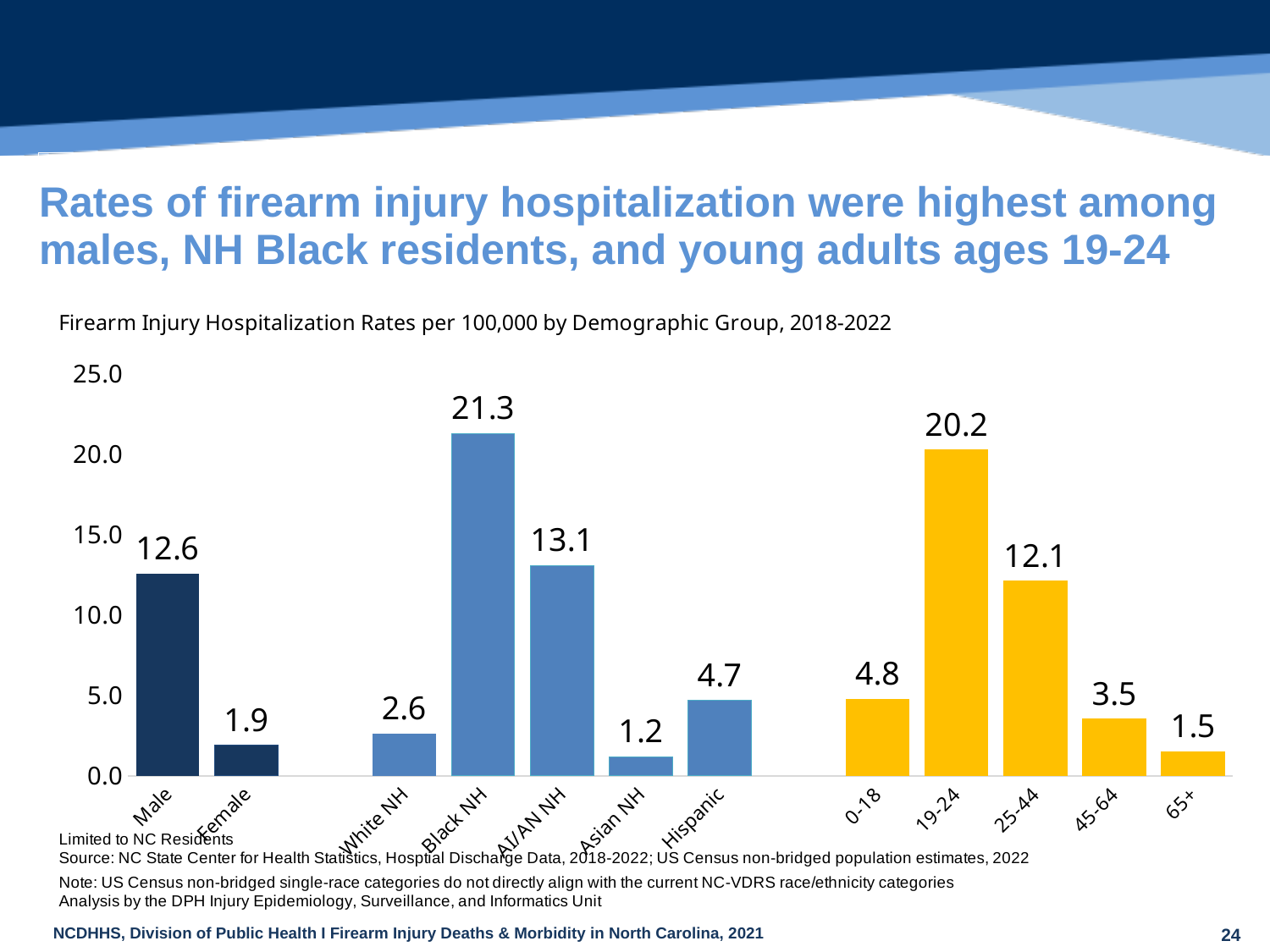
What is the title of the chart? Firearm Injury Hospitalization Rates per 100,000 by Demographic Group, 2018-2022 What is the difference between the hospitalization rates for males and females? 10.7 What kind of chart is shown on the slide? Bar chart What is the firearm injury hospitalization rate per 100,000 for Hispanic residents? 4.7 What is the firearm injury hospitalization rate per 100,000 for the 19-24 age group? 20.2 What is the firearm injury hospitalization rate per 100,000 for males? 12.6 Which demographic group has the lowest firearm injury hospitalization rate on the chart? Asian NH How many demographic groups are shown on the chart? 12 What is the firearm injury hospitalization rate per 100,000 for Black NH residents? 21.3 Which has a higher hospitalization rate, AI/AN NH residents or the 25-44 age group? AI/AN NH Which demographic group has the highest firearm injury hospitalization rate on the chart? Black NH What is the difference between the hospitalization rates for the 19-24 and 25-44 age groups? 8.1